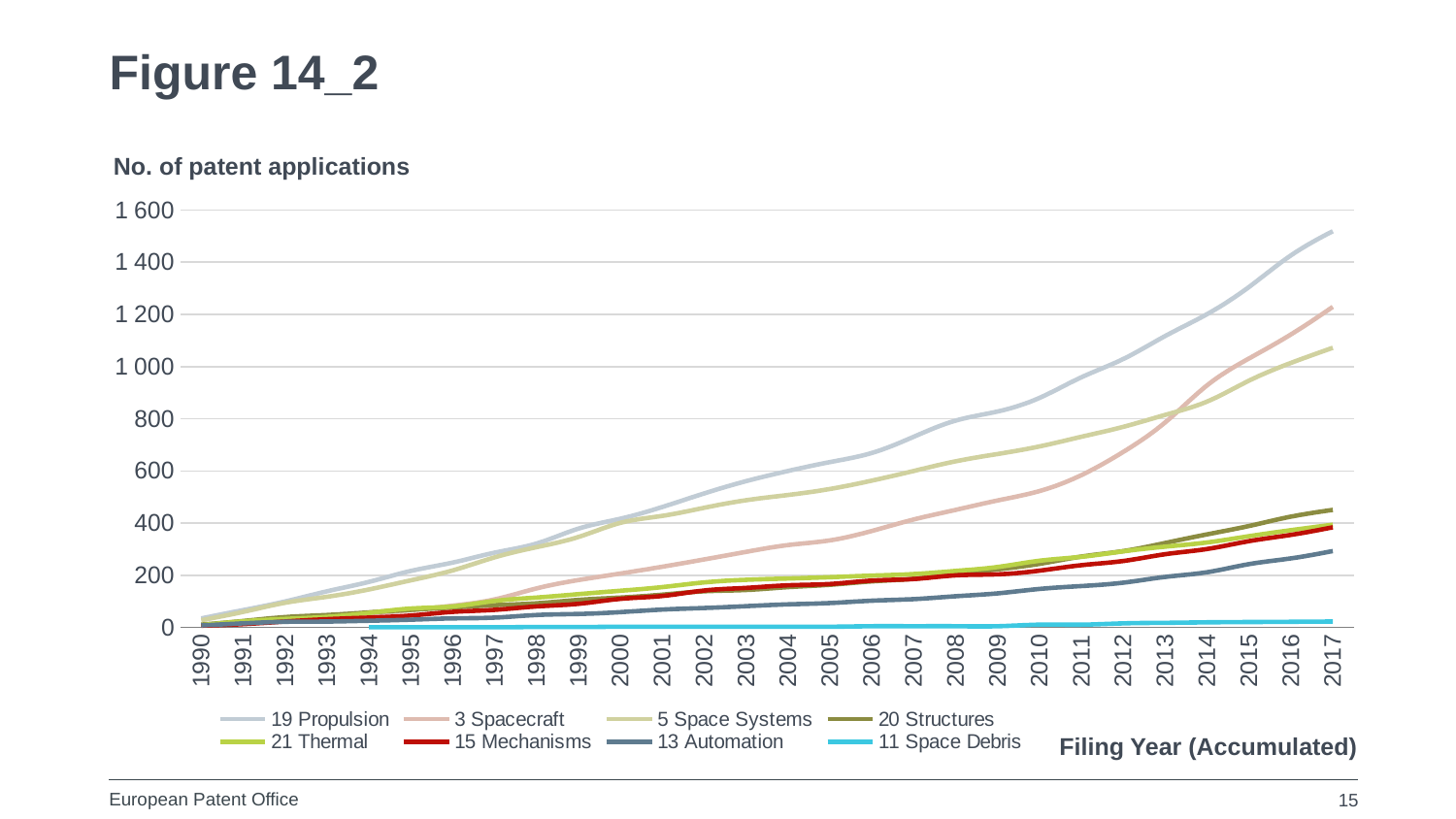
Which series has the lowest value in 2017? 11 Space Debris Which is larger in 2017, 3 Spacecraft or 5 Space Systems? 3 Spacecraft Is the value for 19 Propulsion in 2000 greater or less than 600? less Is the value for 19 Propulsion in 2017 greater or less than 1 400? greater Is the value for 3 Spacecraft in 2017 greater or less than 1 000? greater Which is larger in 2010, 3 Spacecraft or 5 Space Systems? 5 Space Systems How many series does the legend list? 8 What kind of chart is shown on the slide? line chart What is the title of the x axis? Filing Year (Accumulated) How many filing years are shown along the x axis? 28 Which series has the highest value in 2017? 19 Propulsion